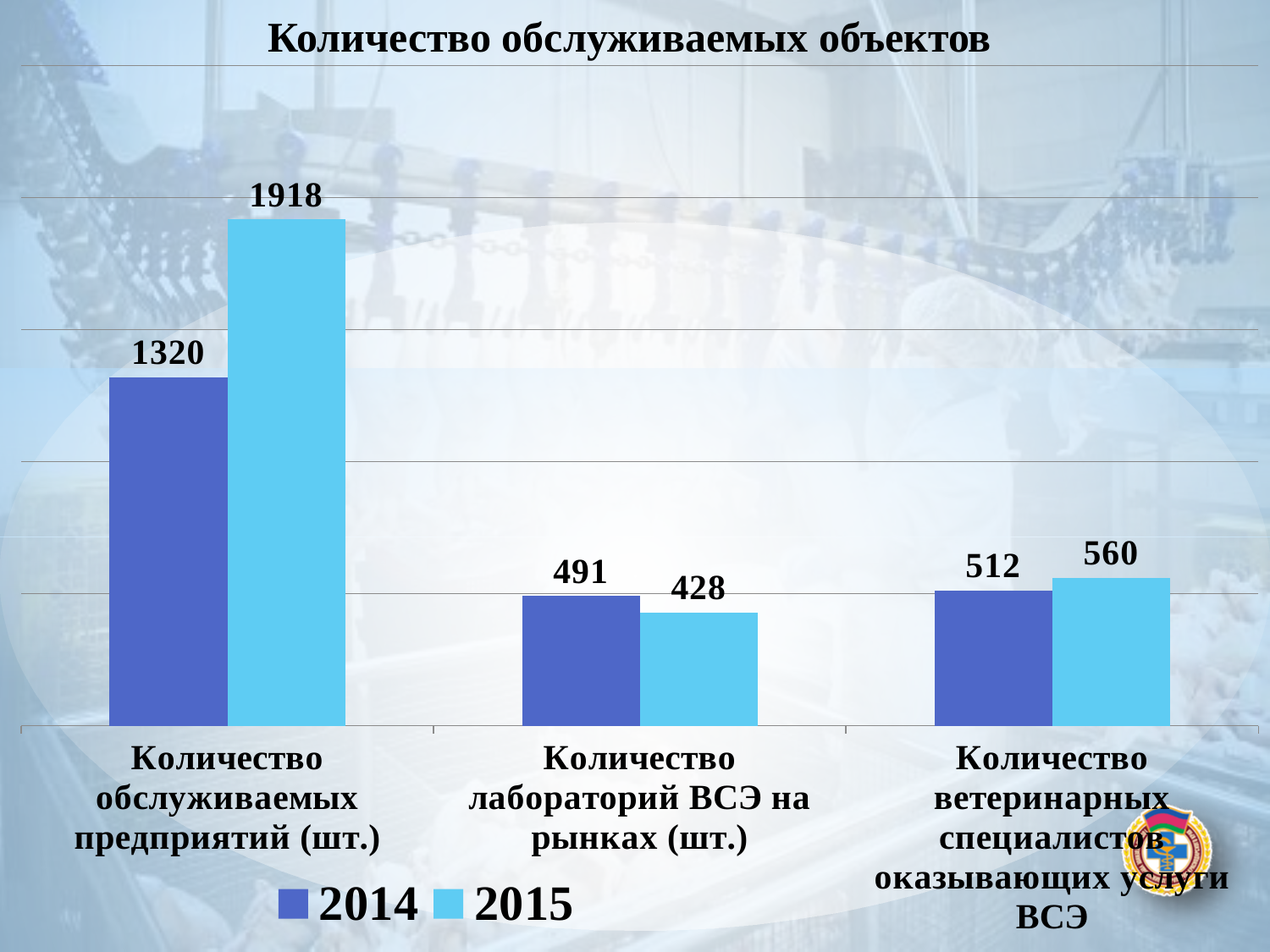
What kind of chart is shown on the slide? Bar chart For Количество ветеринарных специалистов оказывающих услуги ВСЭ, which year has the larger value, 2014 or 2015? 2015 What is the difference between the 2014 and 2015 values for Количество лабораторий ВСЭ на рынках (шт.)? 63 What is the 2015 value for Количество ветеринарных специалистов оказывающих услуги ВСЭ? 560 Which category has the lowest 2015 value? Количество лабораторий ВСЭ на рынках (шт.) What is the 2014 value for Количество лабораторий ВСЭ на рынках (шт.)? 491 How many series does the legend list? 2 What is the title of the chart? Количество обслуживаемых объектов Which category has the highest 2014 value? Количество обслуживаемых предприятий (шт.) What is the 2015 value for Количество обслуживаемых предприятий (шт.)? 1918 What is the difference between the 2015 and 2014 values for Количество обслуживаемых предприятий (шт.)? 598 How many categories are shown on the x axis? 3